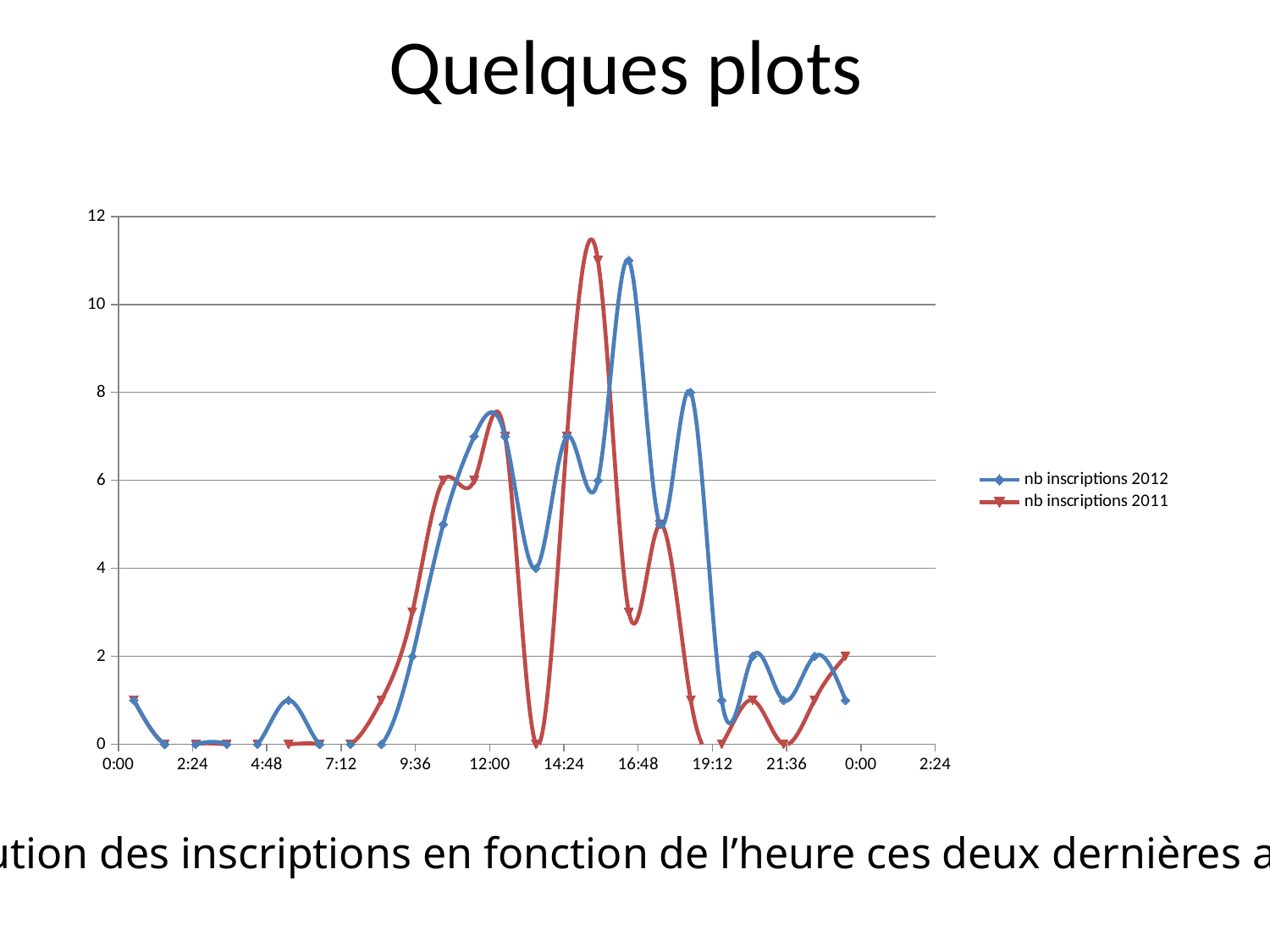
What kind of chart is shown on the slide? line chart At 16:48, which series has the higher value, nb inscriptions 2012 or nb inscriptions 2011? nb inscriptions 2012 Is the highest value of the nb inscriptions 2011 series greater or less than 10? greater Is the highest value of the nb inscriptions 2012 series greater or less than 10? greater Which colour is used for the nb inscriptions 2011 series? red What are the two series named in the legend? nb inscriptions 2012 and nb inscriptions 2011 At 9:36, which series has the higher value, nb inscriptions 2012 or nb inscriptions 2011? nb inscriptions 2011 What is the lowest value reached by the nb inscriptions 2011 series? 0 How many series does the legend list? 2 Is the value of nb inscriptions 2011 at 16:48 greater or less than 4? less Between 7:12 and 12:00, do the values of nb inscriptions 2012 rise or fall? rise